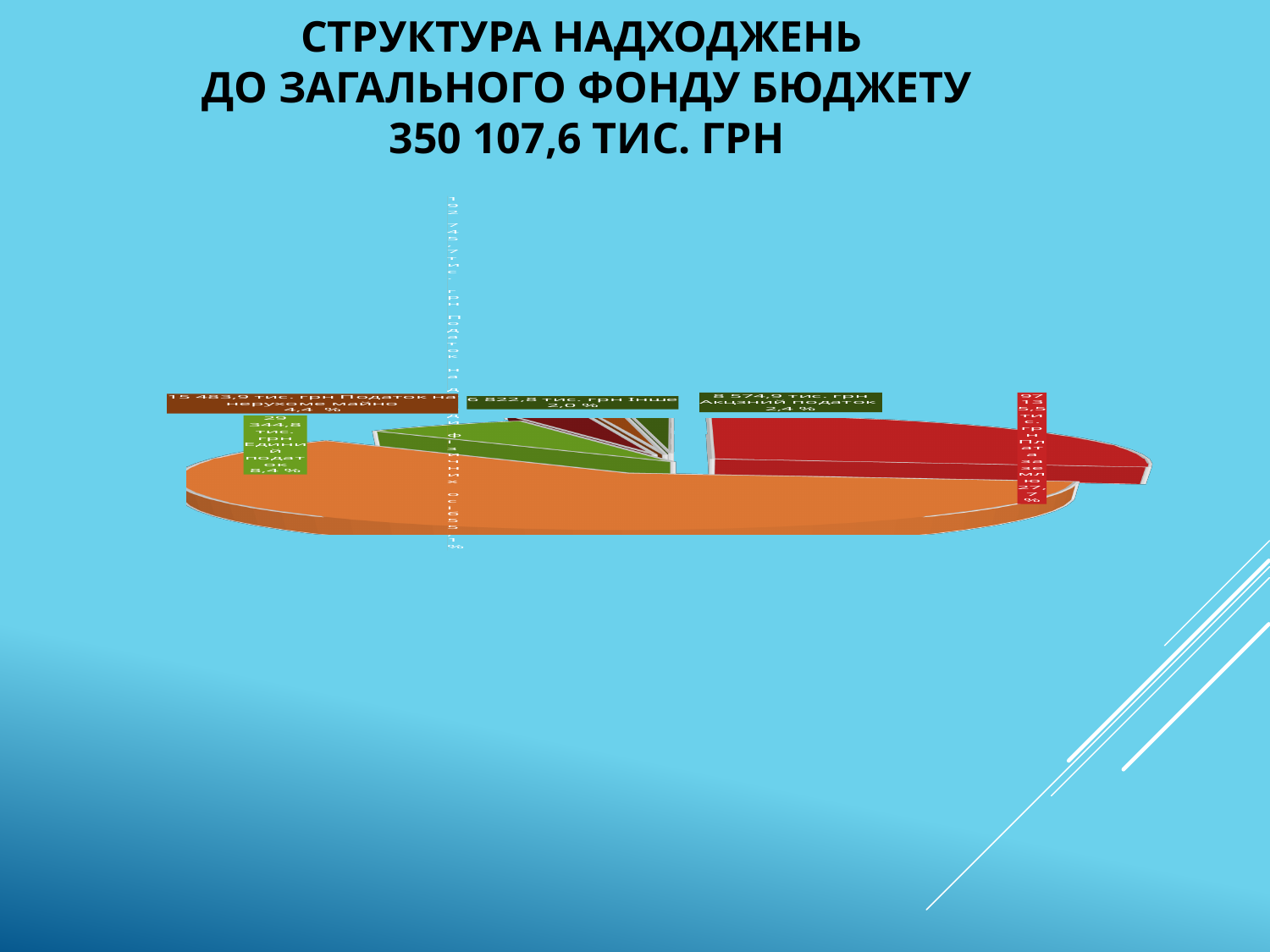
What is the difference between the values for Акцизний податок and Інше? 1 752,1 тис. грн What is the value shown for Інше? 6 822,8 тис. грн By how many percentage points does the share of Податок на нерухоме майно exceed the share of Інше? 2,4 % What total amount is stated in the chart title? 350 107,6 тис. грн What is the value shown for Акцизний податок? 8 574,9 тис. грн What share of the pie does Інше have? 2,0 % What share of the pie does Акцизний податок have? 2,4 % What share of the pie does Єдиний податок have? 8,4 % Which is larger, Акцизний податок or Інше? Акцизний податок What kind of chart is shown on the slide? pie chart What is the value shown for Податок на нерухоме майно? 15 483,9 тис. грн